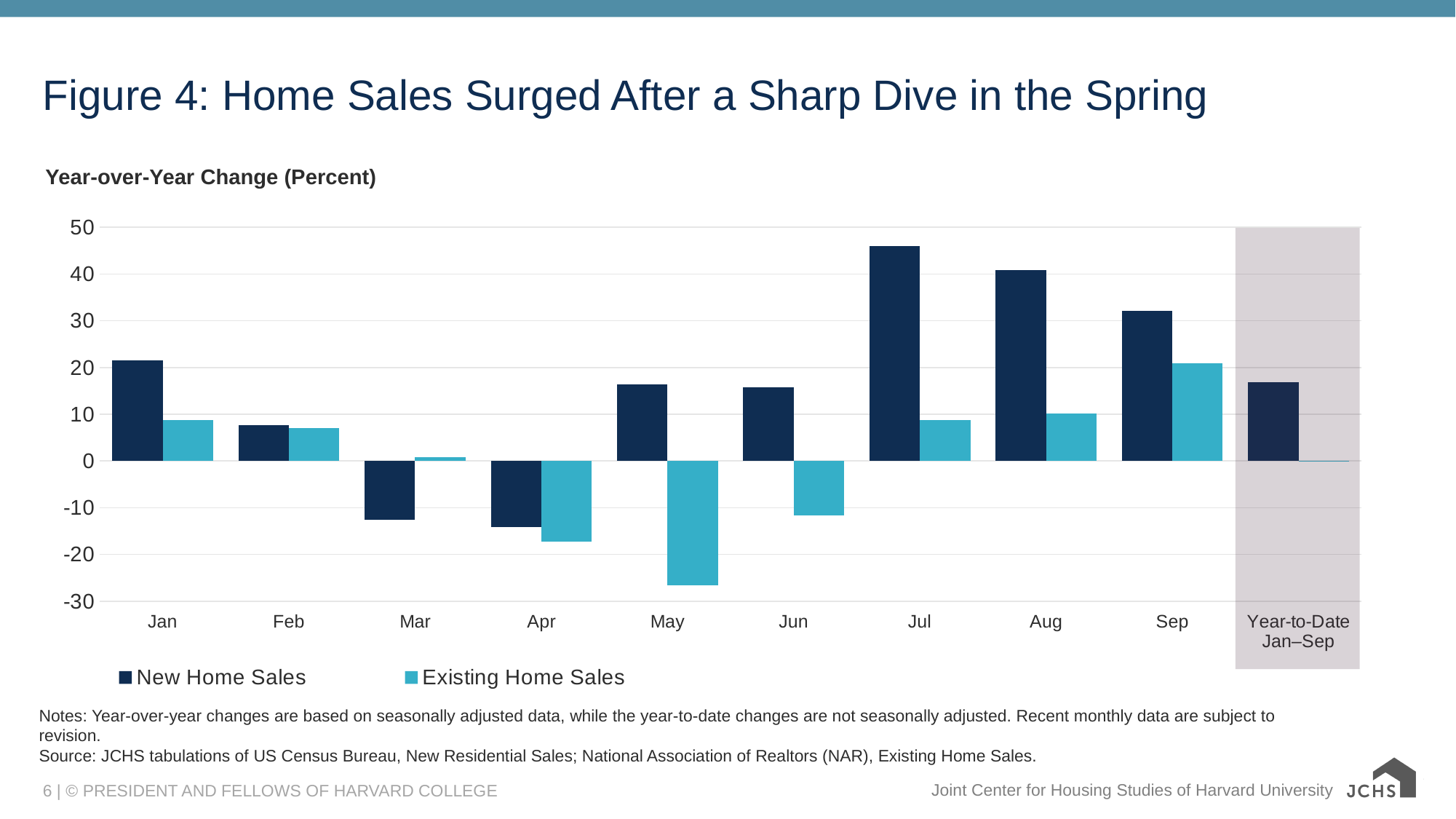
What is the title of the chart? Figure 4: Home Sales Surged After a Sharp Dive in the Spring Which is larger, the New Home Sales value for Jul or for Aug? Jul In which month is the Existing Home Sales year-over-year change lowest? May Is the New Home Sales value for Year-to-Date Jan–Sep greater or less than 10? greater What kind of chart is shown on the slide? bar chart How many categories are shown along the x axis? 10 In which month is the New Home Sales year-over-year change highest? Jul Is the New Home Sales value for Jul greater or less than 40? greater Which is larger in Jan, New Home Sales or Existing Home Sales? New Home Sales How many series does the legend list? 2 Is the Existing Home Sales value for May greater or less than -20? less In which month is the Existing Home Sales year-over-year change highest? Sep